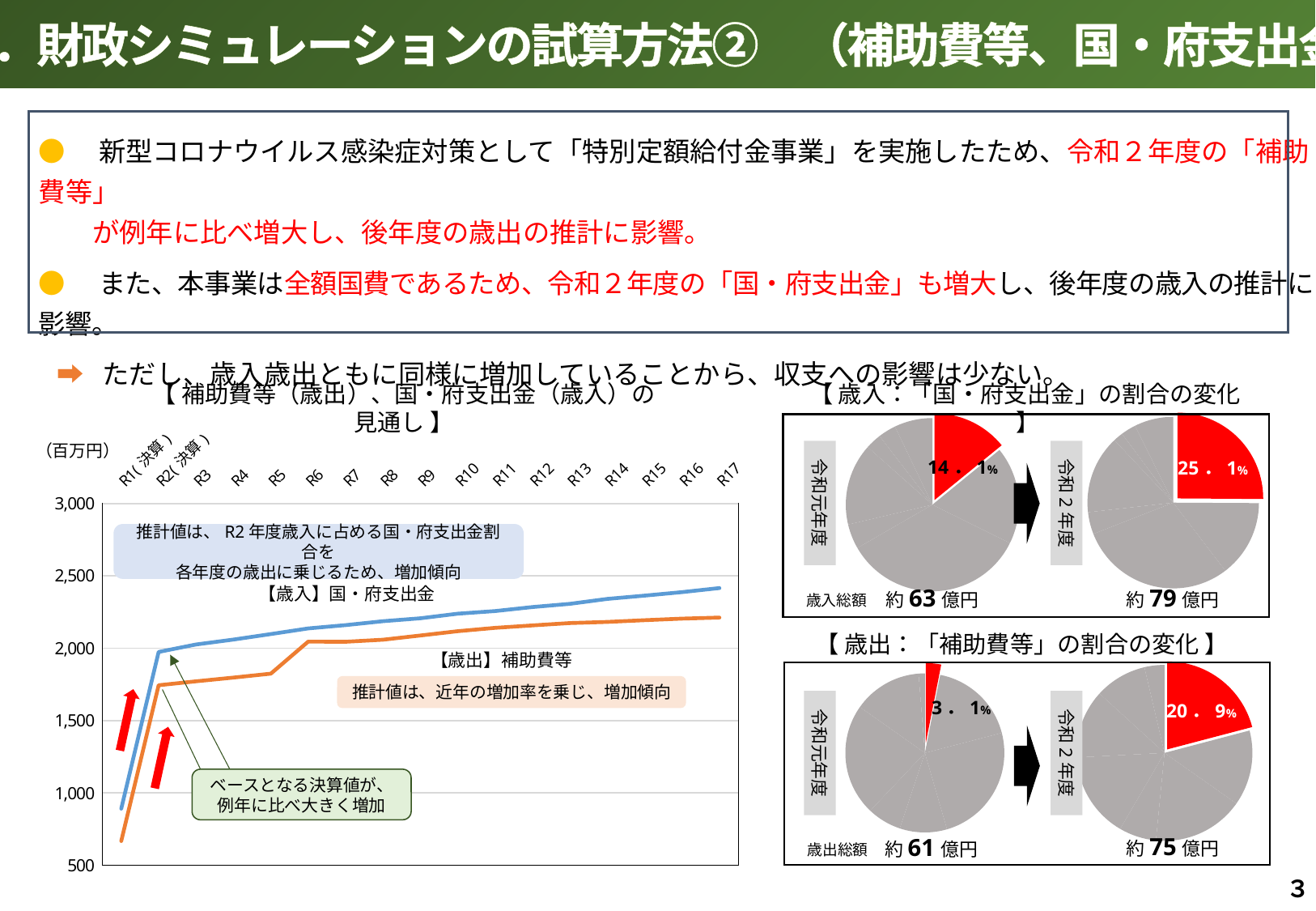
In the left line chart, is the value for 【歳入】国・府支出金 at R17 greater or less than 2,000? greater In the 【歳出：「補助費等」の割合の変化】 pie charts, by how many percentage points does the 補助費等 share increase from 令和元年度 (3.1%) to 令和2年度 (20.9%)? 17.8 percentage points In the 【歳出：「補助費等」の割合の変化】 pie charts, what share does 補助費等 have in 令和2年度? 20.9% In the left line chart, which series is higher at R17, 【歳入】国・府支出金 or 【歳出】補助費等? 【歳入】国・府支出金 In the 【歳入：「国・府支出金」の割合の変化】 pie charts, what share does 国・府支出金 have in 令和元年度? 14.1% What kind of chart is the chart on the left of the slide (【補助費等（歳出）、国・府支出金（歳入）の見通し】)? line chart In the left line chart, how many series does the chart show? 2 In the 【歳入：「国・府支出金」の割合の変化】 pie charts, what is the 歳入総額 shown for 令和2年度? 約79億円 In the left line chart, do the values for 【歳入】国・府支出金 rise or fall from R2(決算) to R17? rise In the left line chart, is the value for 【歳出】補助費等 at R1(決算) greater or less than 1,000? less In the 【歳入：「国・府支出金」の割合の変化】 pie charts, what share does 国・府支出金 have in 令和2年度? 25.1% In the left line chart, how many years are shown along the x axis (from R1(決算) to R17)? 17